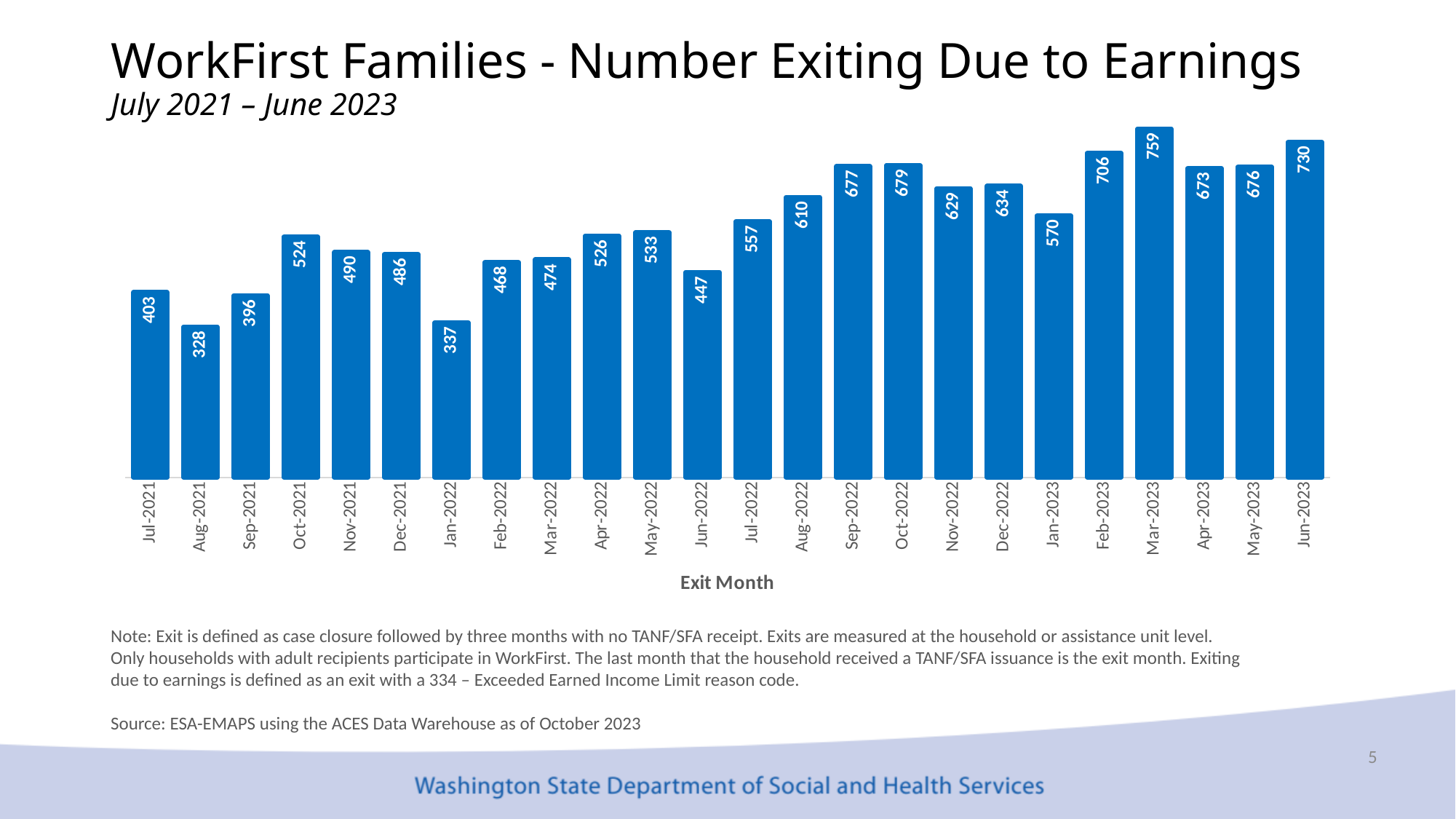
Overall, do the values rise or fall from Jul-2021 to Jun-2023? Rise Which is larger, the value for Oct-2021 or the value for Jun-2022? Oct-2021 Which month has the highest number of exits due to earnings? Mar-2023 What is the label of the x axis? Exit Month How many months are plotted on the chart? 24 What is the difference between the values for Sep-2022 and Oct-2022? 2 What is the difference between the values for Jun-2023 and Jul-2021? 327 What kind of chart is shown on the slide? Bar chart What is the value shown for Jul-2021? 403 Which month has the lowest number of exits due to earnings? Aug-2021 What is the value shown for Jan-2022? 337 What is the number of WorkFirst families exiting due to earnings in Mar-2023? 759